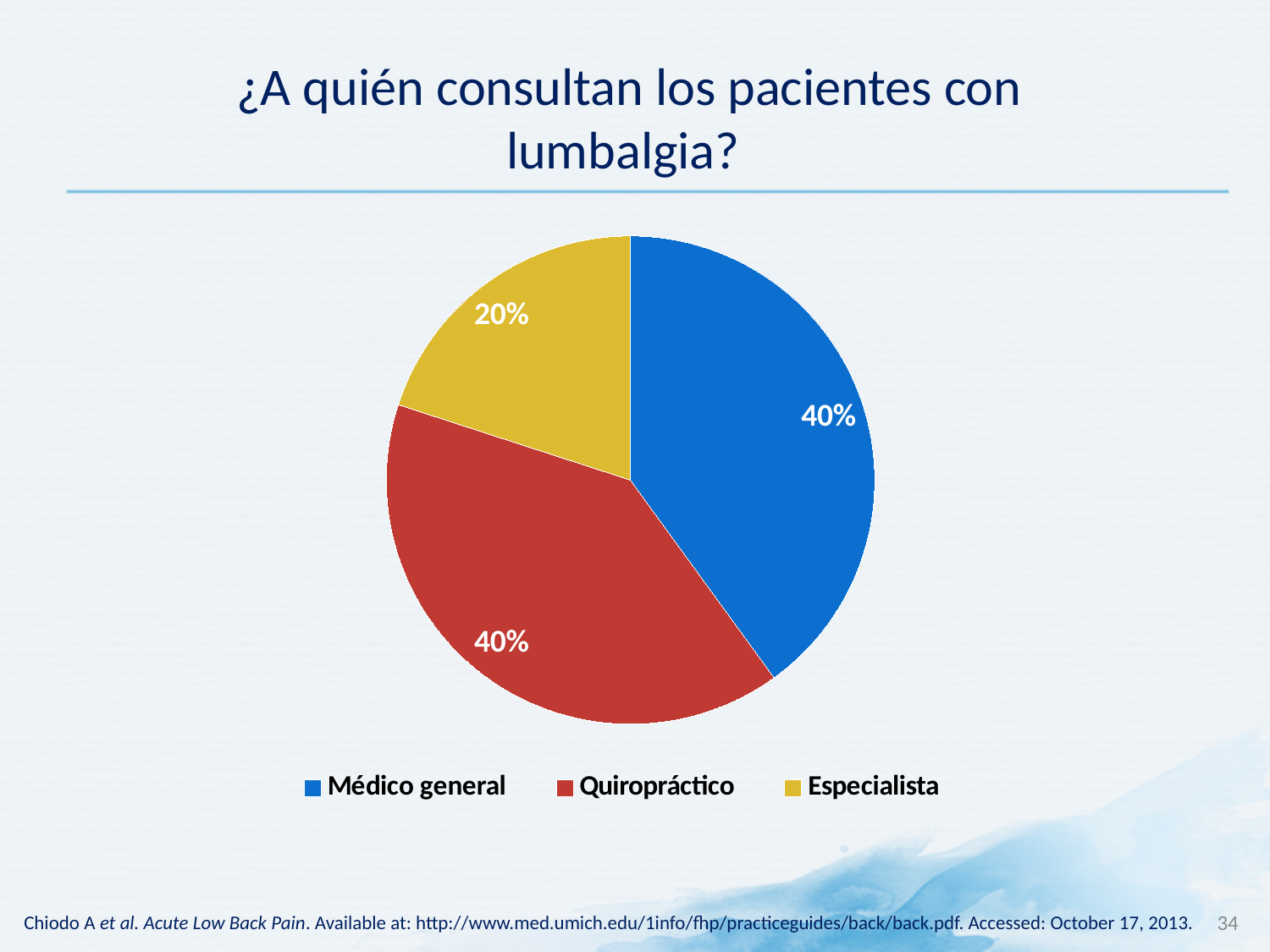
What is the combined share of Médico general and Quiropráctico? 80% What is the difference between the share for Médico general and the share for Especialista? 20% Is the share for Especialista greater or less than 25%? less What share of the pie does Médico general represent? 40% Which is larger, the share for Quiropráctico or the share for Especialista? Quiropráctico What share of the pie does Quiropráctico represent? 40% What share of the pie does Especialista represent? 20% Which colour represents Especialista in the pie chart? Yellow How many categories does the pie chart show? 3 What kind of chart is shown on the slide? Pie chart Which category has the smallest slice of the pie? Especialista What is the title of the slide containing the chart? ¿A quién consultan los pacientes con lumbalgia?